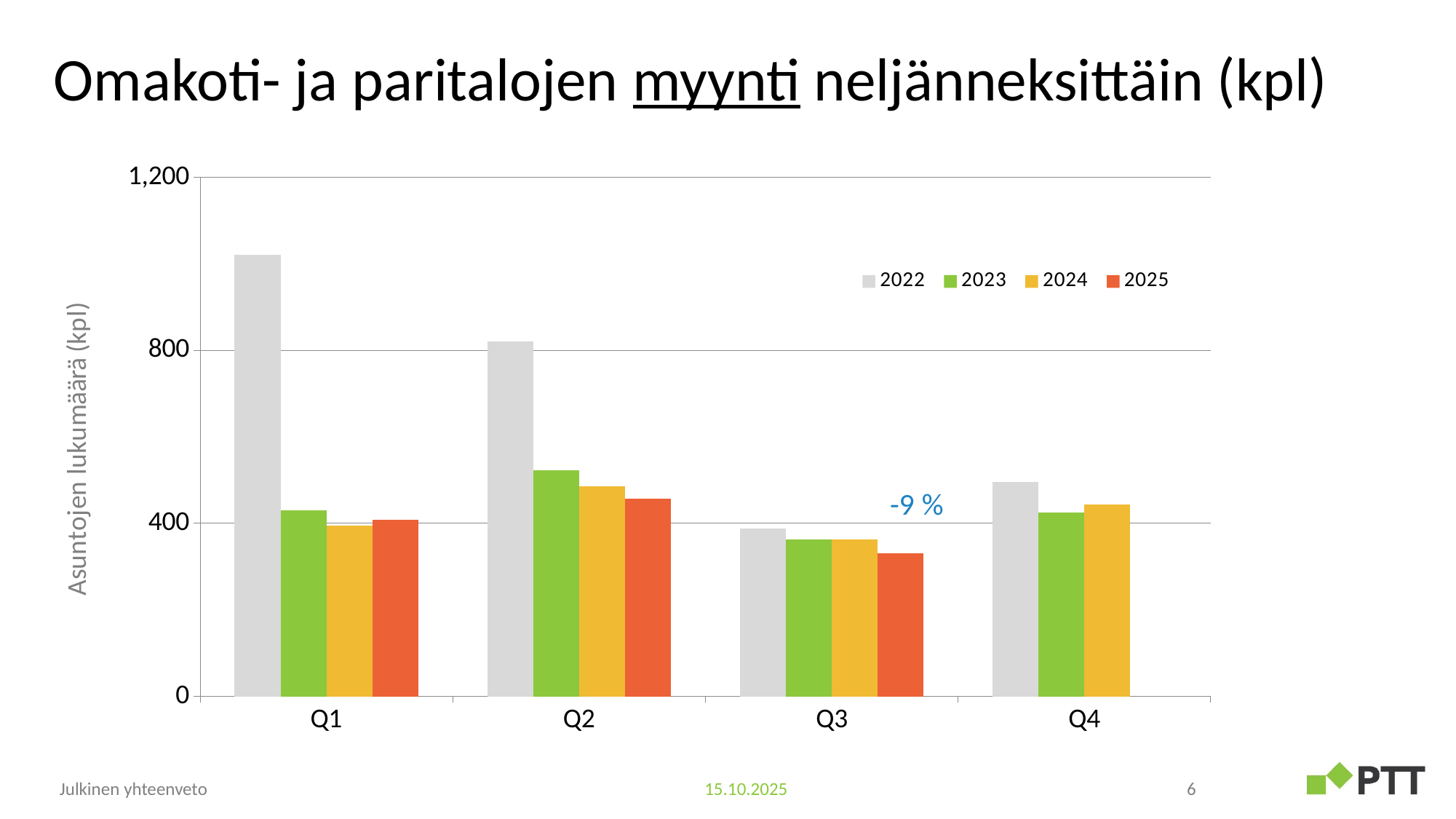
Next to which quarter is the annotation "-9 %" placed? Q3 In which quarter is the 2025 bar the lowest? Q3 Which is larger in Q2: the 2022 bar or the 2023 bar? 2022 Which series has the tallest bar in the Q2 group? 2022 How many bars are plotted for Q4? 3 In which quarter is the 2022 bar the highest? Q1 How many quarters are shown on the x axis? 4 How many series does the legend list? 4 Is the value for 2025 in Q3 greater or less than 400? less Is the value for 2022 in Q1 greater or less than 800? greater What kind of chart is shown on the slide? bar chart Is the value for 2023 in Q2 greater or less than 400? greater